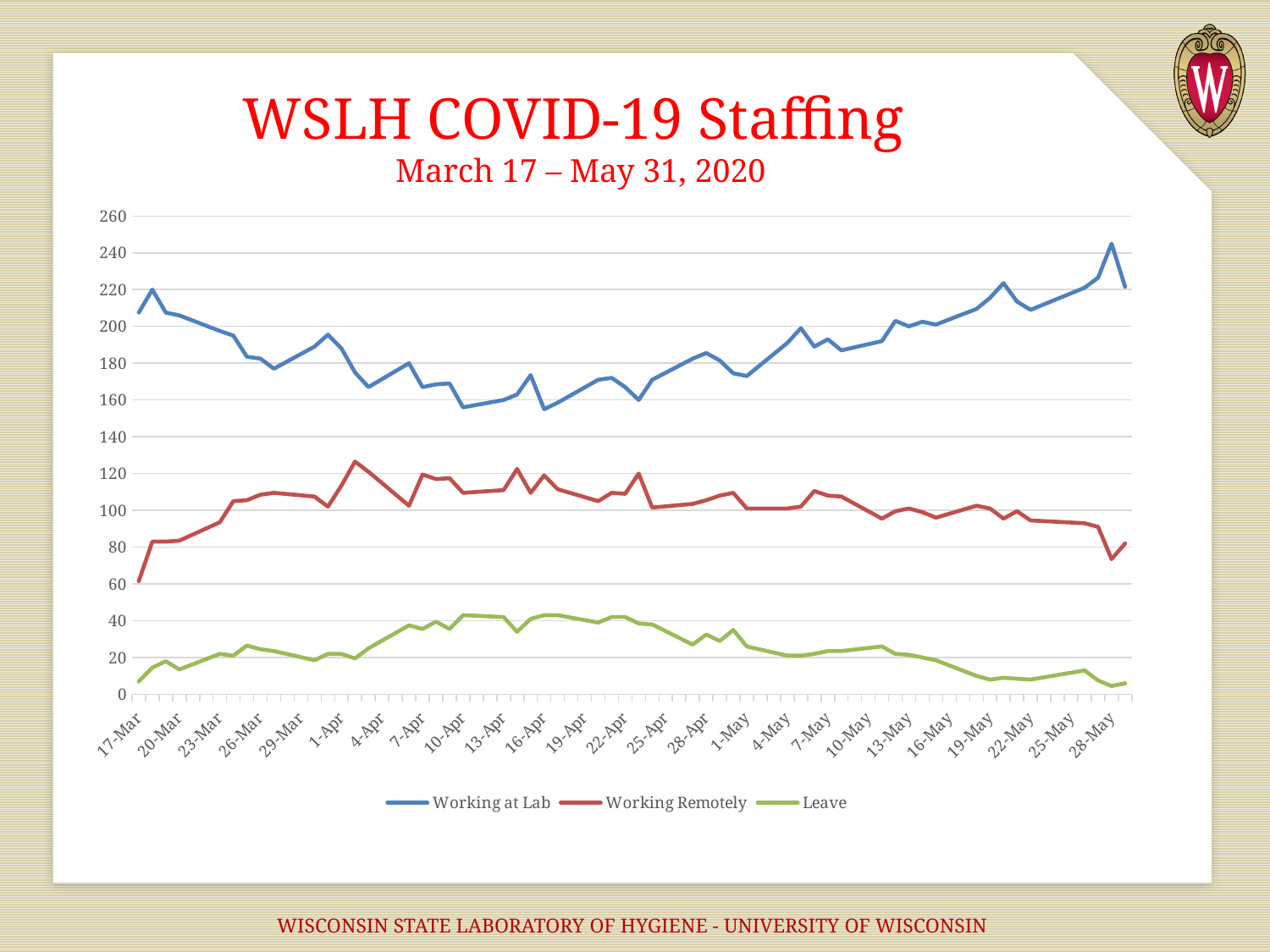
Which series has the lowest values throughout the chart? Leave What is the title of the chart on the slide? WSLH COVID-19 Staffing Is the value for Leave on 28-May greater or less than 20? less On 17-Mar, which is larger: Working at Lab or Working Remotely? Working at Lab Is the value for Working at Lab on 17-Mar greater or less than 200? greater What colour is the line for the Leave series? green Does the Working at Lab series generally rise or fall from 10-Apr to 28-May? rise Which series has the highest values throughout the chart? Working at Lab Is the value for Working Remotely on 28-May greater or less than 100? less Does the Leave series generally rise or fall from 16-Apr to 28-May? fall How many series does the legend list? 3 What kind of chart is shown on the slide? line chart